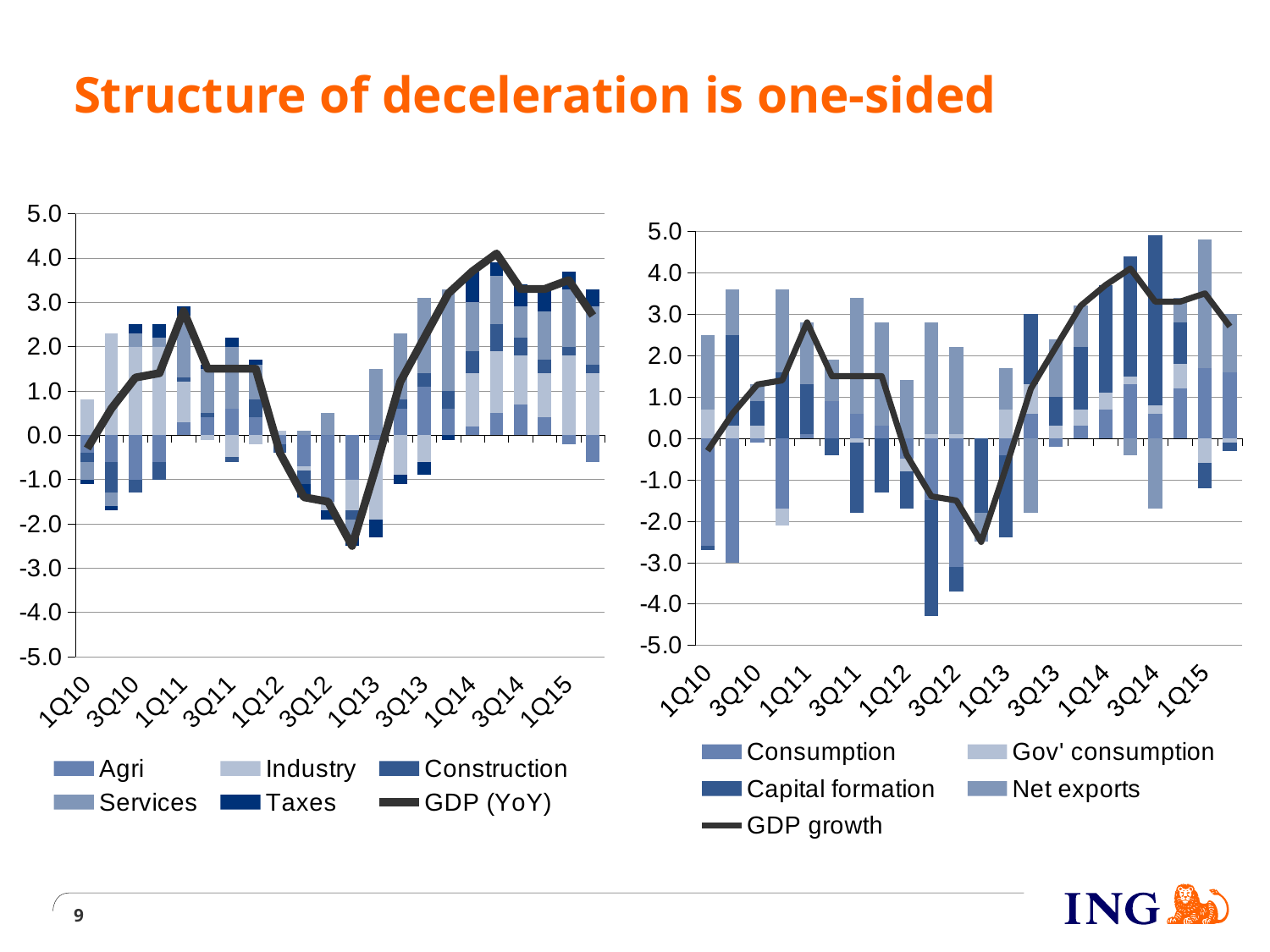
In the left chart, is the GDP (YoY) value at 1Q13 greater or less than -2.0? greater In the left chart, is the GDP (YoY) value at 1Q14 greater or less than 2.0? greater How many series does the legend of the right chart list? 5 How many series does the legend of the left chart list? 6 What kind of chart is the left chart on the slide? Stacked bar chart with a line How many quarter labels are shown on the x axis of the right chart? 11 In the left chart, is the GDP (YoY) value higher at 3Q14 or at 1Q13? 3Q14 In the right chart, does the GDP growth line rise or fall between 1Q13 and 3Q14? rise In the right chart, is the GDP growth value at 3Q14 greater or less than 3.0? greater What is the title of the slide? Structure of deceleration is one-sided